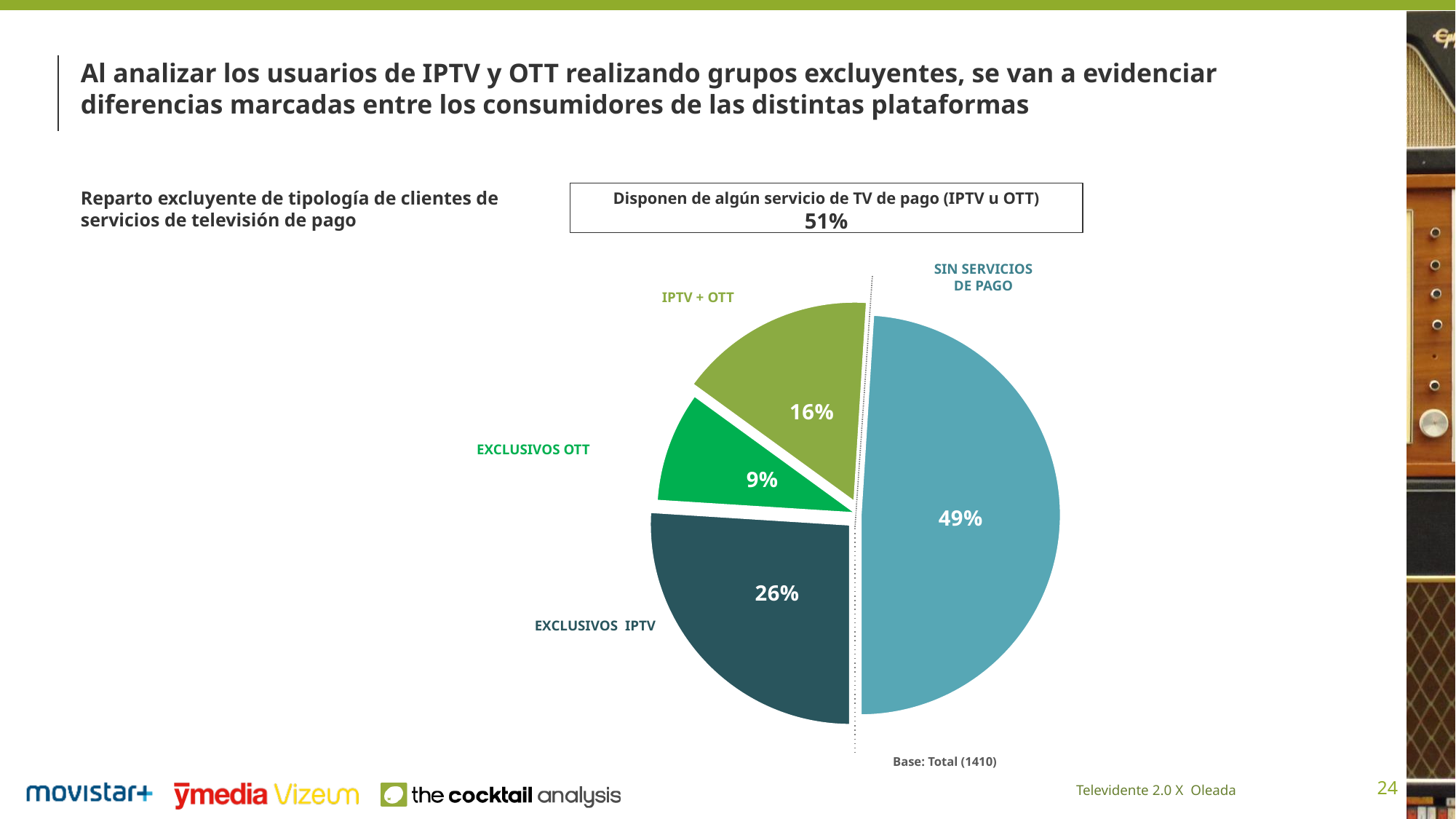
Which slice of the pie chart is the largest? SIN SERVICIOS DE PAGO What percentage is shown in the box for those who have some pay TV service (IPTV u OTT)? 51% How many slices does the pie chart have? 4 What percentage of the pie chart corresponds to SIN SERVICIOS DE PAGO? 49% What is the base (total) stated below the pie chart? Total (1410) What percentage of the pie chart corresponds to IPTV + OTT? 16% What percentage of the pie chart corresponds to EXCLUSIVOS OTT? 9% What kind of chart is shown on the slide? Pie chart Which slice of the pie chart is the smallest? EXCLUSIVOS OTT Which is larger, the IPTV + OTT slice or the EXCLUSIVOS OTT slice? IPTV + OTT What percentage of the pie chart corresponds to EXCLUSIVOS IPTV? 26% What is the difference in percentage points between EXCLUSIVOS IPTV and EXCLUSIVOS OTT? 17